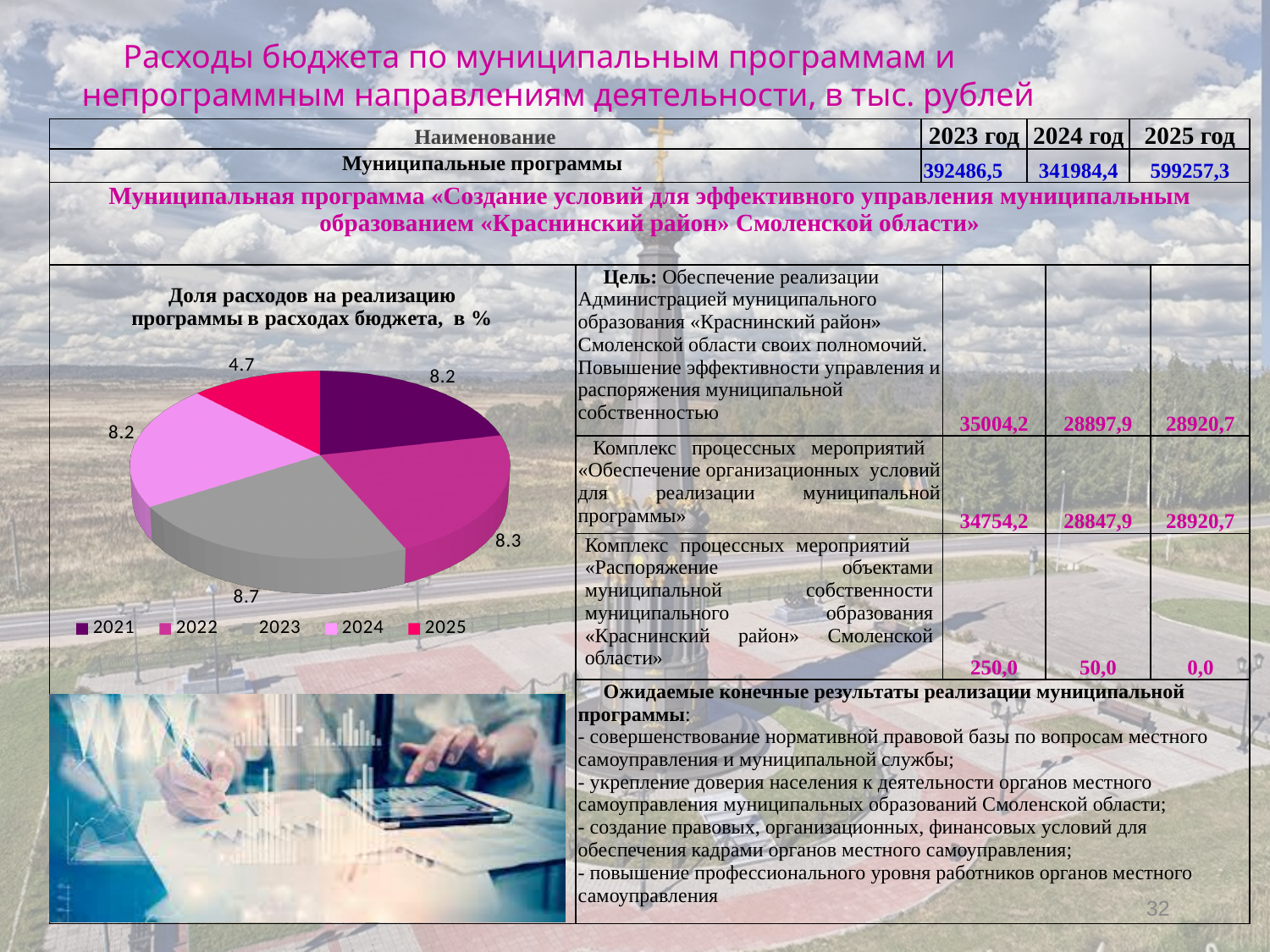
What value is shown for 2025 in the pie chart? 4.7 What kind of chart is shown on the slide? pie chart What is the difference between the values for 2023 and 2025 in the pie chart? 4.0 How many years does the legend of the pie chart list? 5 Which year has the smallest value in the pie chart? 2025 How many slices does the pie chart have? 5 What value is shown for 2021 in the pie chart? 8.2 What is the title of the pie chart? Доля расходов на реализацию программы в расходах бюджета, в % What value is shown for 2023 in the pie chart? 8.7 Which year has the largest value in the pie chart? 2023 What value is shown for 2022 in the pie chart? 8.3 Which is larger in the pie chart, the value for 2022 or the value for 2025? 2022